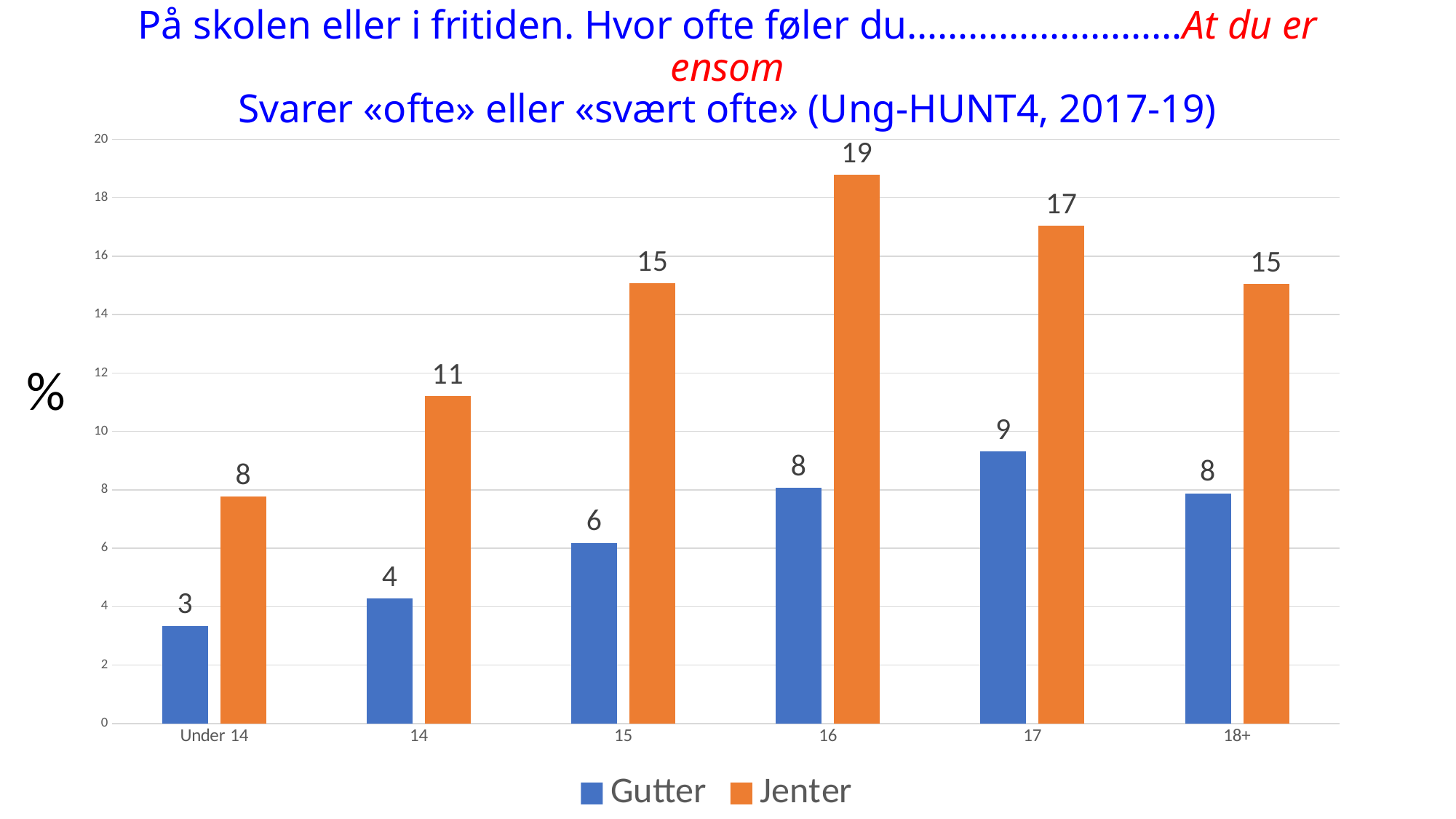
What is the value for Gutter in the Under 14 age group? 3 What is the difference between the Jenter and Gutter values in the 15 age group? 9 How many series does the legend list? 2 What is the value for Jenter in the 16 age group? 19 Which age group has the lowest value for Gutter? Under 14 Which age group has the highest value for Jenter? 16 Is the value for Jenter in the 17 age group greater or less than 16? greater Which colour represents Jenter in the chart? Orange What kind of chart is shown on the slide? Bar chart Which is larger in the 14 age group, the value for Gutter or the value for Jenter? Jenter What is the value for Gutter in the 17 age group? 9 How many age groups are shown on the x axis? 6